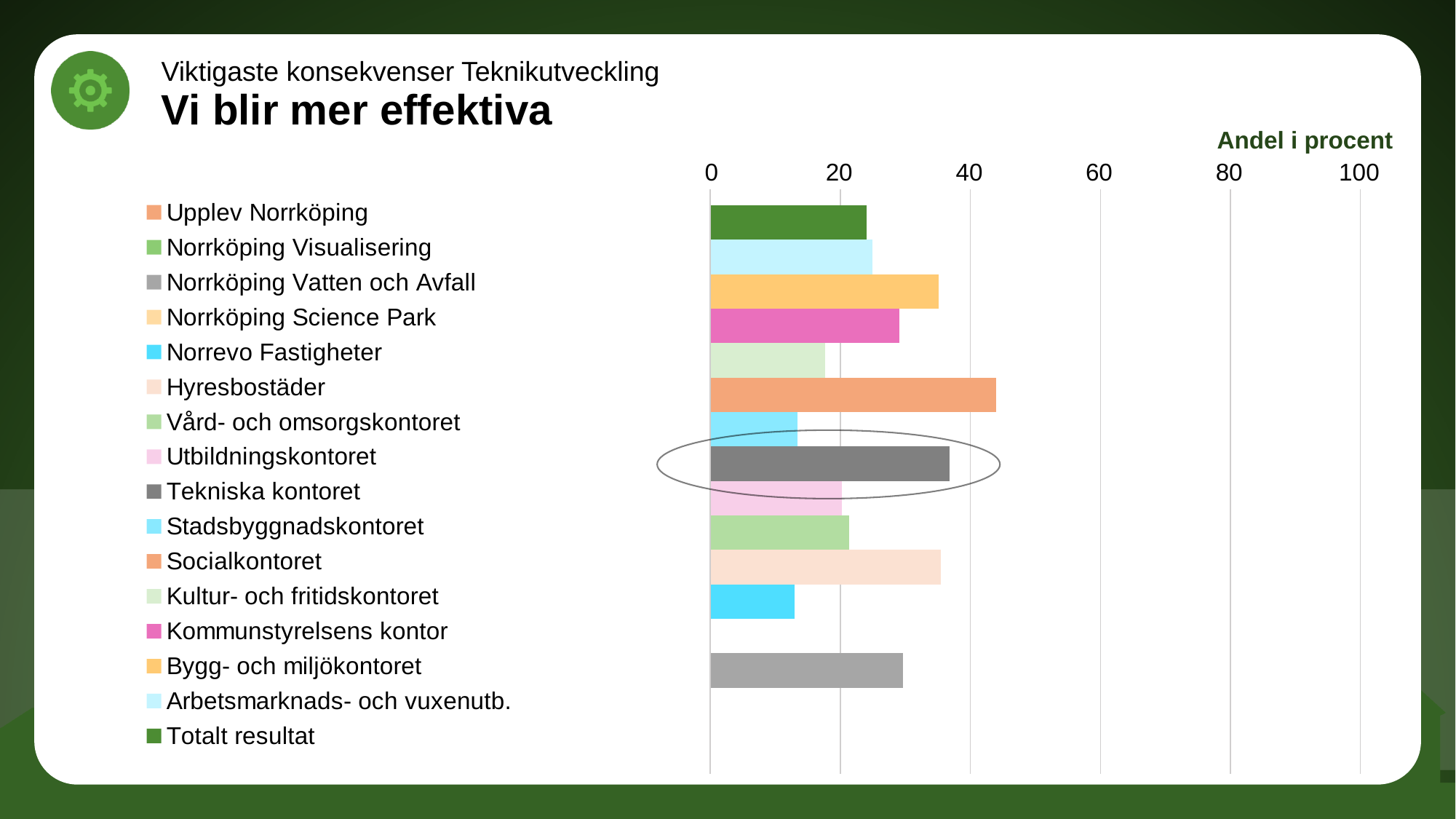
Is the value for Kommunstyrelsens kontor greater or less than 20? greater Is the value for Norrevo Fastigheter greater or less than 20? less What kind of chart is shown on the slide? bar chart Is the value for Socialkontoret greater or less than 40? greater What is the title shown above the horizontal axis of the chart? Andel i procent How many entries does the legend list? 16 Which category's bar is circled on the chart? Tekniska kontoret Which category has the longest bar? Socialkontoret Which is larger, the value for Socialkontoret or the value for Tekniska kontoret? Socialkontoret